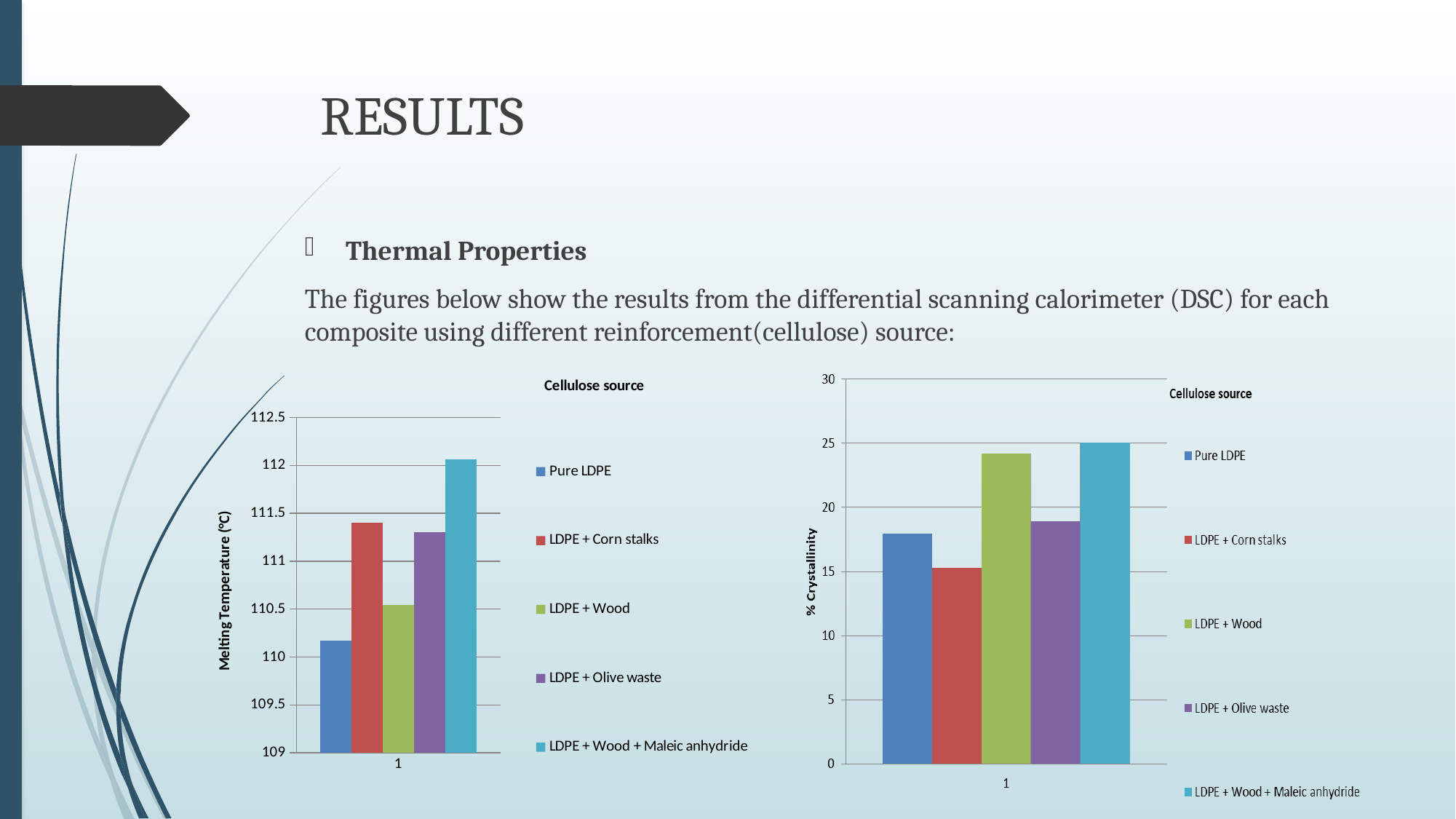
In the left chart (Melting Temperature), is the value for LDPE + Corn stalks greater or less than 111? greater How many series does the legend of the left chart (Melting Temperature) list? 5 In the right chart (% Crystallinity), which cellulose source has the lowest crystallinity? LDPE + Corn stalks In the right chart (% Crystallinity), is the value for Pure LDPE greater or less than 20? less In the left chart (Melting Temperature), which cellulose source has the highest melting temperature? LDPE + Wood + Maleic anhydride In the right chart (% Crystallinity), which is larger, the value for LDPE + Wood or the value for LDPE + Corn stalks? LDPE + Wood In the right chart (% Crystallinity), is the value for LDPE + Wood greater or less than 20? greater What type of chart is the left chart showing Melting Temperature (°C)? bar chart In the left chart (Melting Temperature), which cellulose source has the lowest melting temperature? Pure LDPE What is the y-axis label of the right chart? % Crystallinity